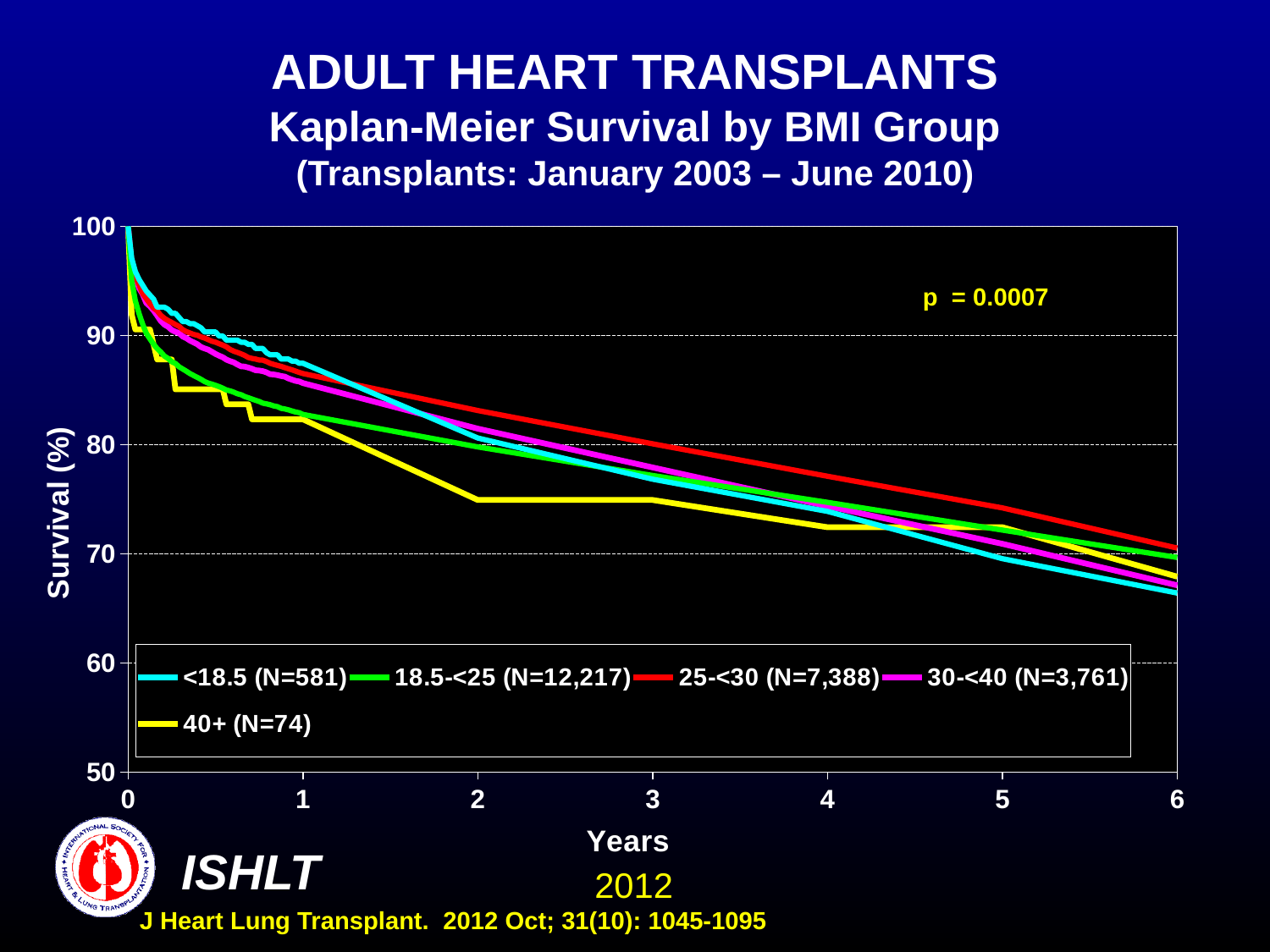
Is the survival for the 40+ group at year 1 greater or less than 80? greater Is the survival for the 18.5-<25 group at year 4 greater or less than 70? greater Is the survival for the <18.5 group at year 6 greater or less than 70? less What is the label of the y-axis? Survival (%) What is the N for the 18.5-<25 BMI group in the legend? 12,217 What is the p-value printed on the chart? p = 0.0007 What kind of chart is shown on the slide? line chart Which BMI group has the lowest survival at year 2? 40+ (N=74) Do the survival curves rise or fall as years increase? fall How many BMI groups (series) does the legend list? 5 At year 2, is survival higher for the 25-<30 group or the 40+ group? 25-<30